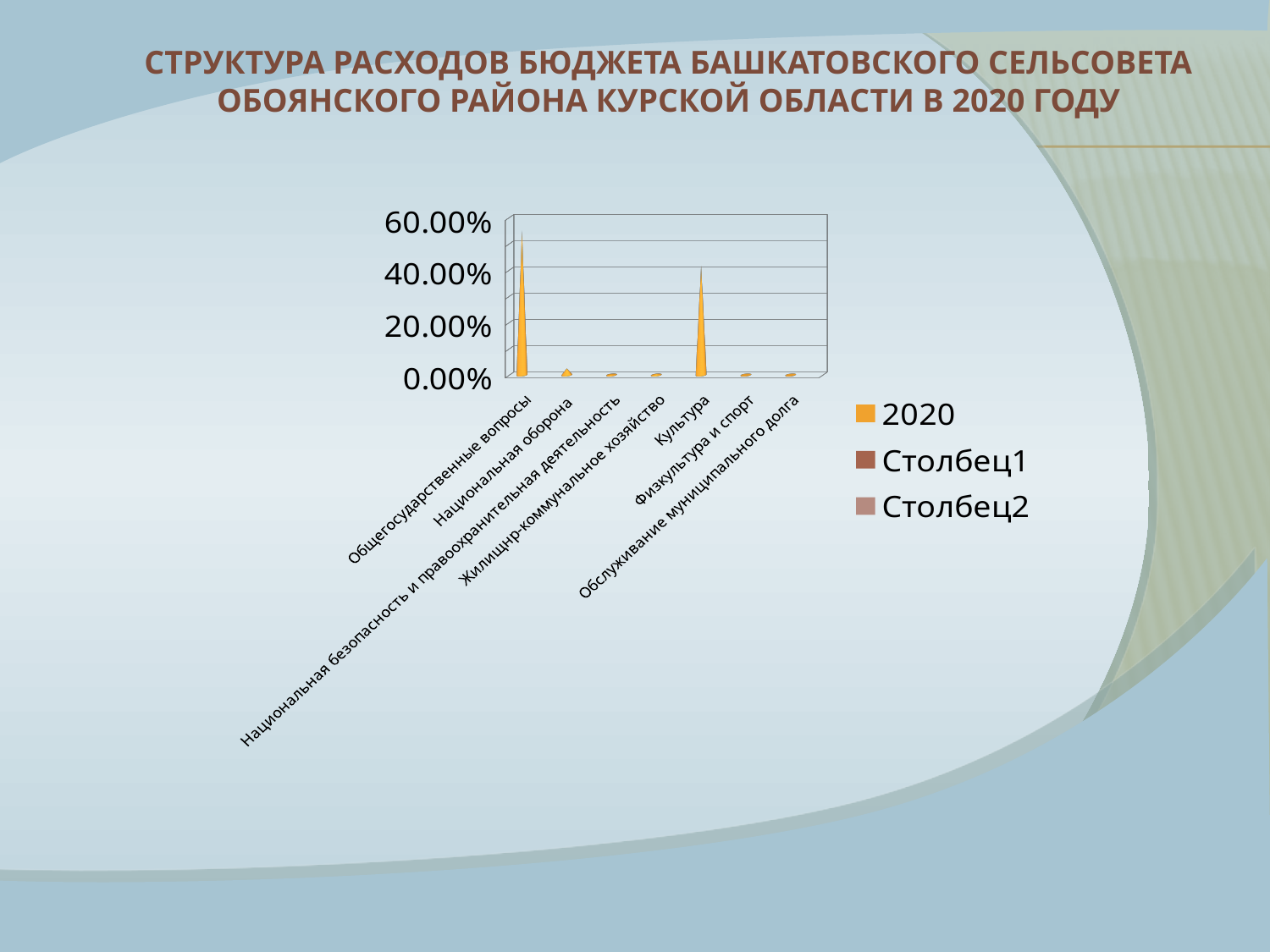
Is the value for Культура greater or less than 60.00%? less How many series does the chart legend list? 3 Which category has the highest value in the chart? Общегосударственные вопросы Is the value for Культура greater or less than 20.00%? greater How many categories are shown on the x axis of the chart? 7 Is the value for Национальная оборона greater or less than 20.00%? less Which is larger, the value for Общегосударственные вопросы or the value for Культура? Общегосударственные вопросы Which is larger, the value for Культура or the value for Физкультура и спорт? Культура What is the first entry listed in the chart legend? 2020 What kind of chart is shown on the slide? bar chart What is the highest value shown on the chart's vertical axis? 60.00%